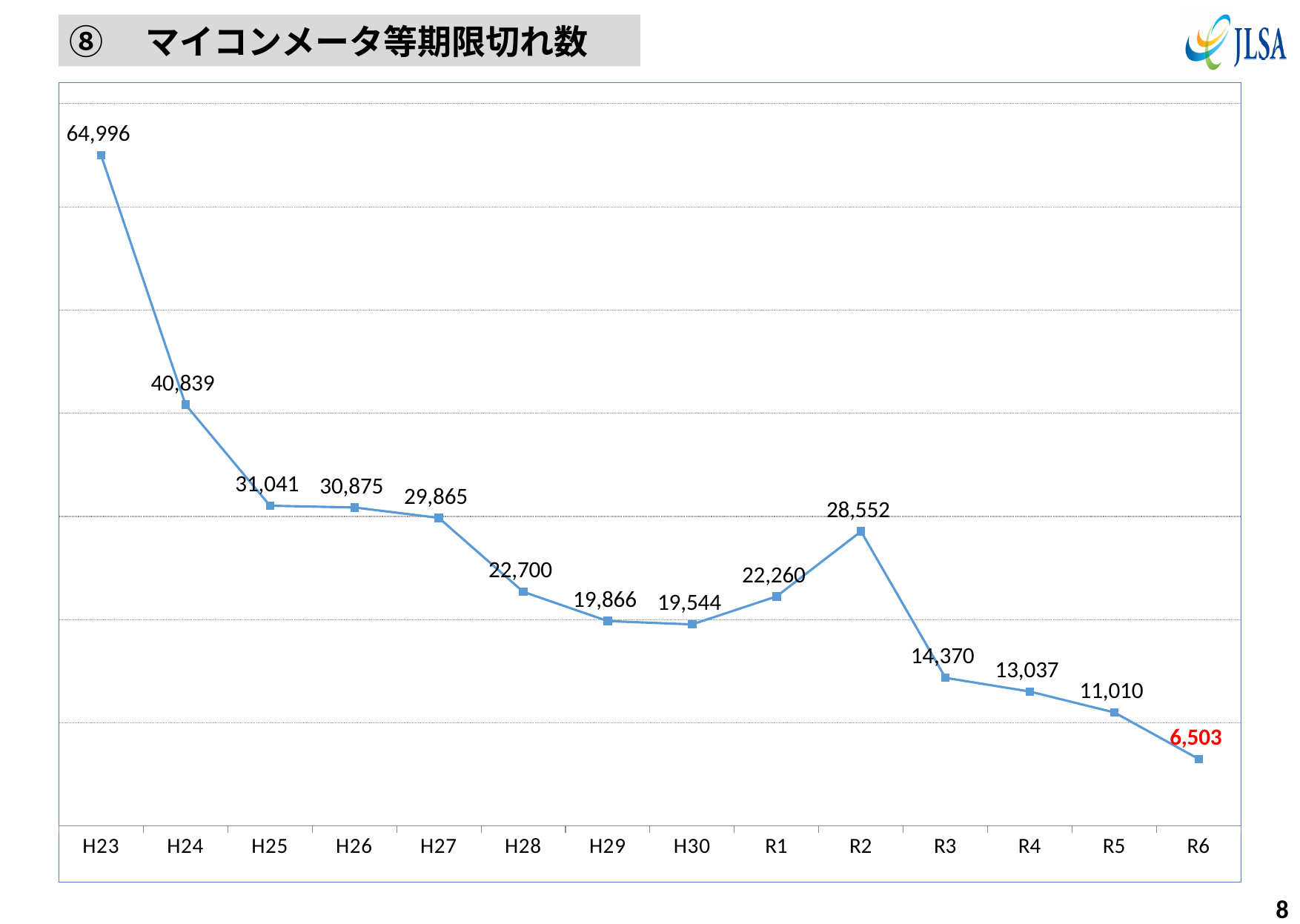
What is the value for R2? 28,552 Which is larger, the value for R1 or the value for H28? H28 What is the value for H23? 64,996 What is the difference between the values for R2 and R3? 14,182 Do the values generally rise or fall from H23 to R6? Fall What kind of chart is shown? Line chart What is the difference between the values for H23 and H24? 24,157 How many years are plotted on the x axis? 14 What is the value for H30? 19,544 What is the value for R6? 6,503 Which year has the highest value? H23 Which year has the lowest value? R6